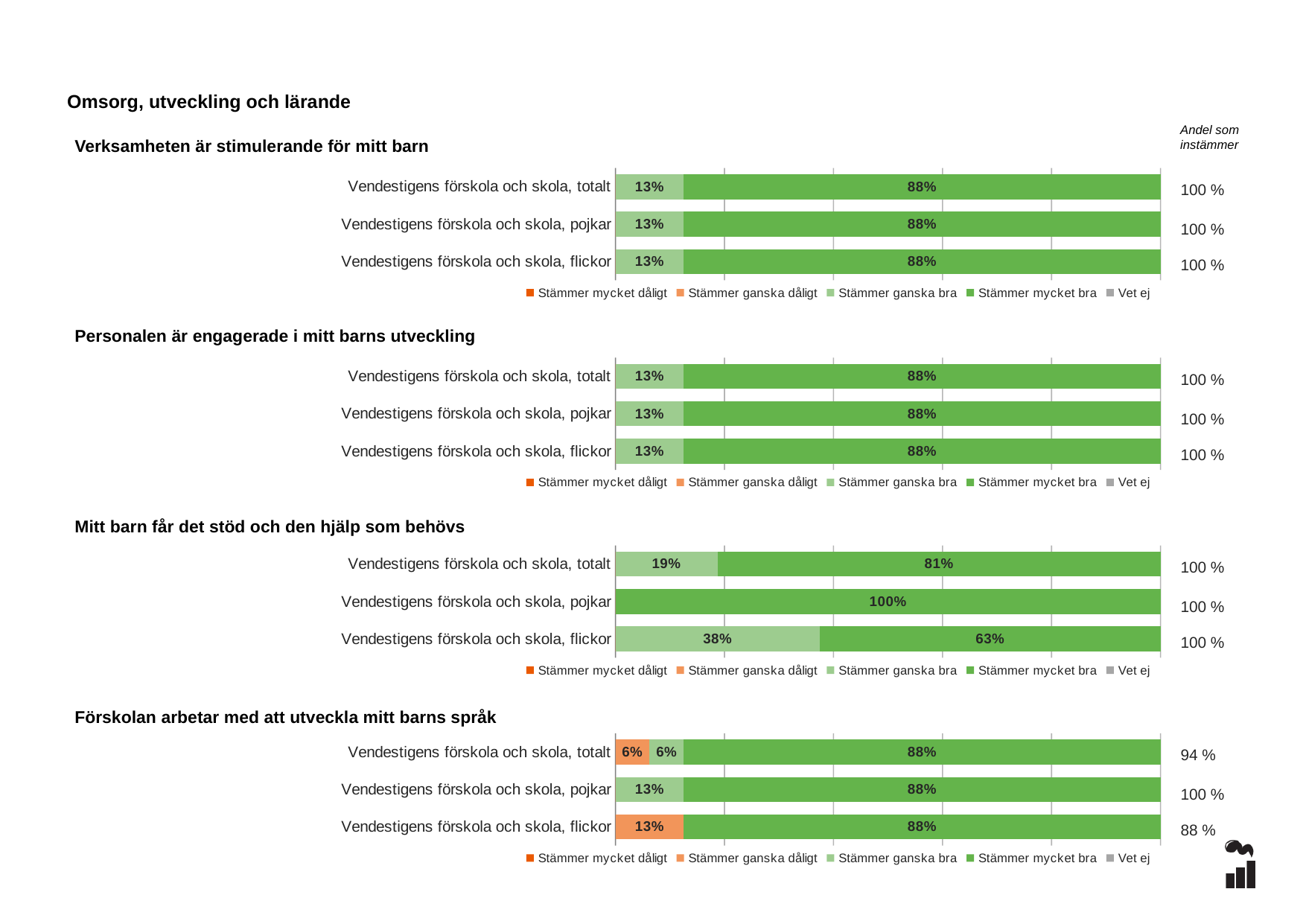
How many rows (categories) does the chart 'Personalen är engagerade i mitt barns utveckling' show? 3 In the chart 'Förskolan arbetar med att utveckla mitt barns språk', what is the 'Andel som instämmer' shown for Vendestigens förskola och skola, totalt? 94 % What kind of chart is used for 'Verksamheten är stimulerande för mitt barn'? Stacked bar chart In the chart 'Mitt barn får det stöd och den hjälp som behövs', what is the 'Stämmer ganska bra' value for Vendestigens förskola och skola, flickor? 38% In the chart 'Mitt barn får det stöd och den hjälp som behövs', what is the difference between the 'Stämmer ganska bra' values for flickor and totalt? 19% In the chart 'Mitt barn får det stöd och den hjälp som behövs', which row has the lowest 'Stämmer mycket bra' value? Vendestigens förskola och skola, flickor In the chart 'Mitt barn får det stöd och den hjälp som behövs', which row has the highest 'Stämmer mycket bra' value? Vendestigens förskola och skola, pojkar In the chart 'Förskolan arbetar med att utveckla mitt barns språk', which row has the lowest 'Andel som instämmer'? Vendestigens förskola och skola, flickor How many series does the legend list under each chart? 5 In the chart 'Mitt barn får det stöd och den hjälp som behövs', what is the 'Stämmer mycket bra' value for Vendestigens förskola och skola, totalt? 81% In the chart 'Verksamheten är stimulerande för mitt barn', what is the 'Stämmer mycket bra' value for Vendestigens förskola och skola, pojkar? 88% In the chart 'Förskolan arbetar med att utveckla mitt barns språk', what is the 'Stämmer ganska dåligt' value for Vendestigens förskola och skola, flickor? 13%